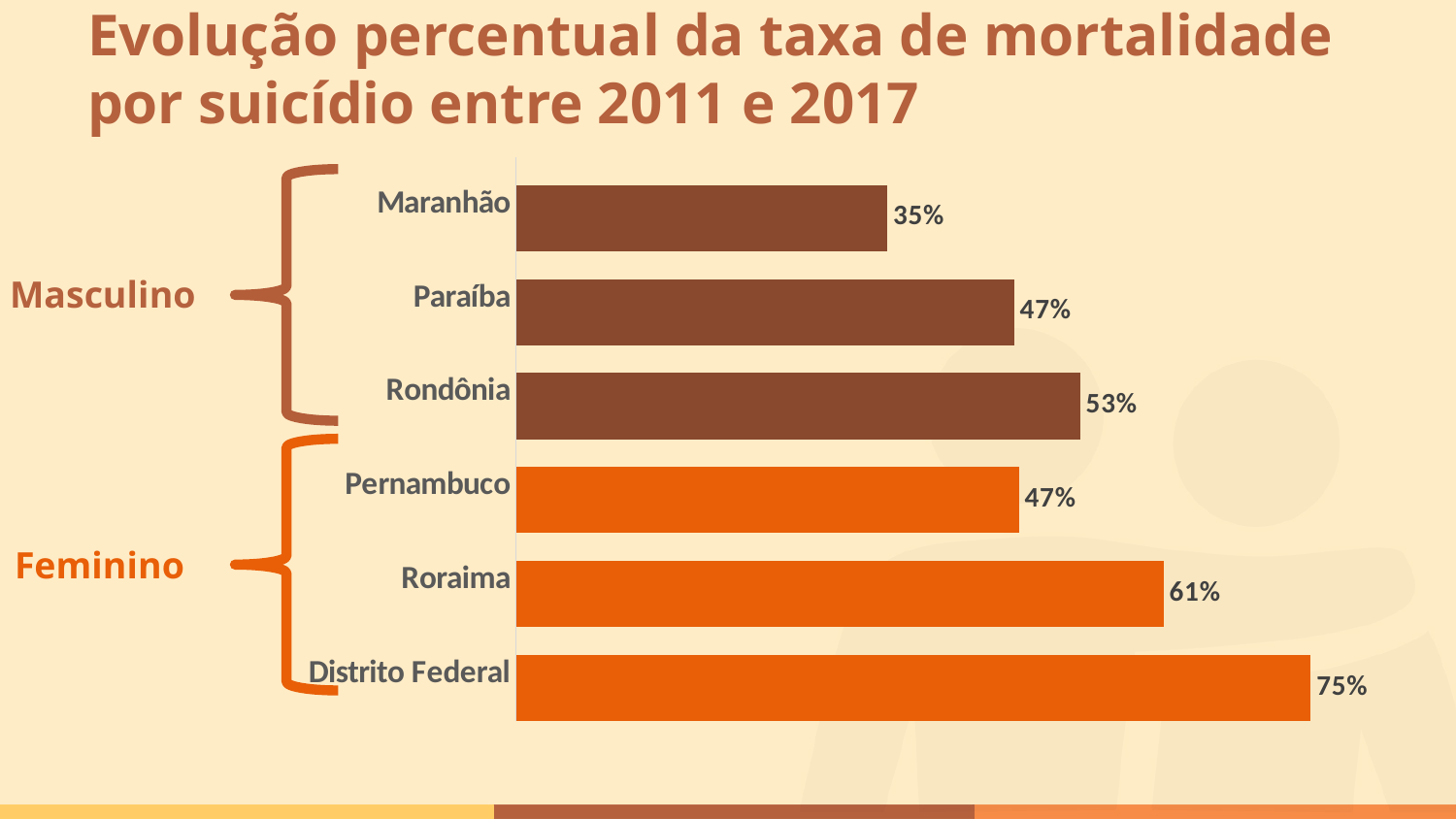
What is the value for Distrito Federal? 75% Which category has the highest value? Distrito Federal Which group label is attached to the bars for Pernambuco, Roraima and Distrito Federal? Feminino What is the difference between the values for Distrito Federal and Maranhão? 40% Which is larger, the value for Rondônia or the value for Paraíba? Rondônia What kind of chart is shown on the slide? Bar chart What is the value for Maranhão? 35% How many categories are shown in the chart? 6 What is the value for Roraima? 61% Which category has the lowest value? Maranhão What is the difference between the values for Roraima and Pernambuco? 14% What is the value for Rondônia? 53%